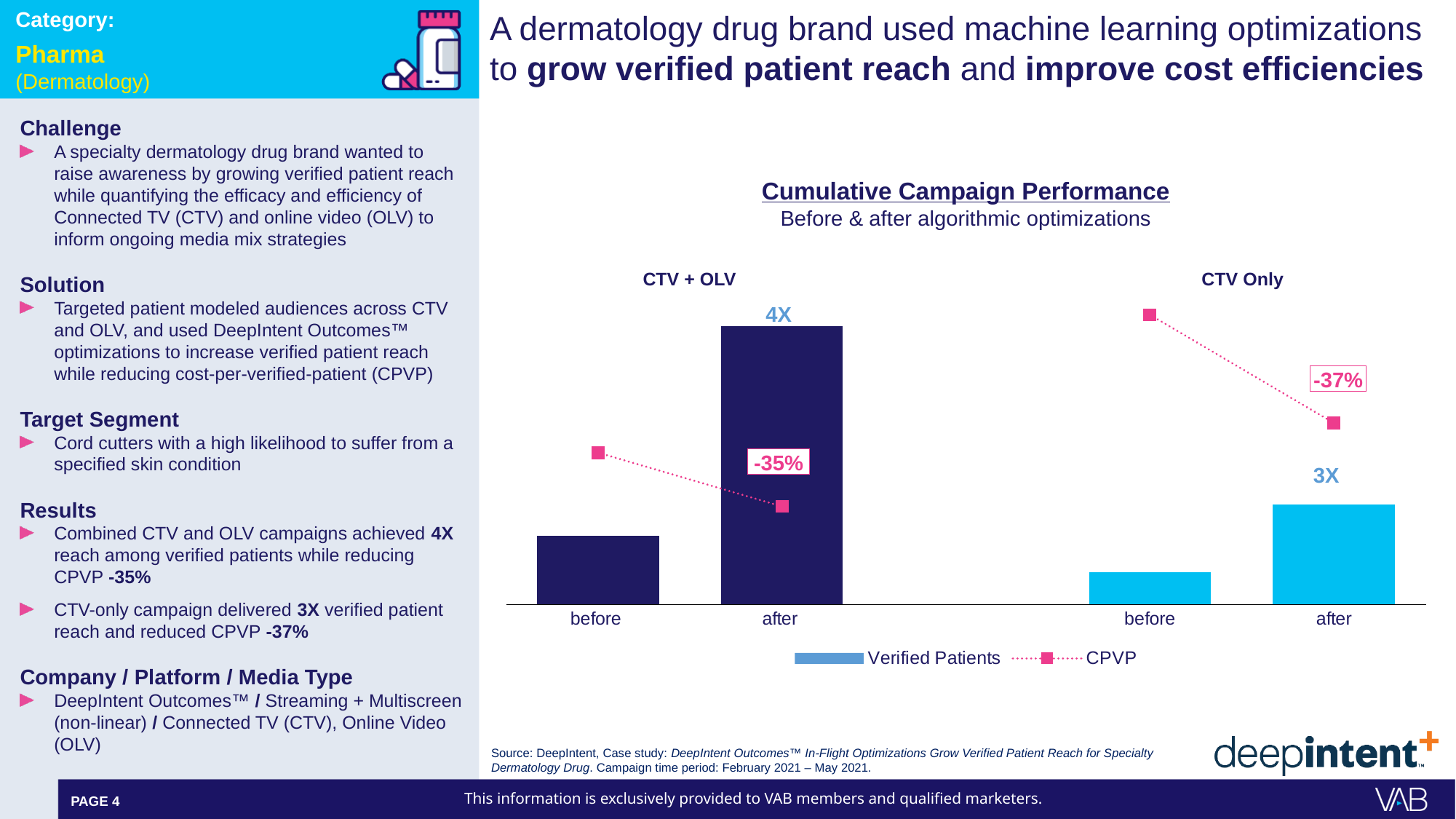
What kind of chart is used to show Verified Patients? bar chart What change in CPVP is labeled for the CTV + OLV campaign? -35% Does the CPVP line rise or fall from before to after for CTV Only? fall What is the chart's title? Cumulative Campaign Performance What is the data label on the 'after' Verified Patients bar for CTV Only? 3X How many Verified Patients bars are plotted in total? 4 Which bar is the tallest on the chart? CTV + OLV after How many series does the legend list? 2 What change in CPVP is labeled for the CTV Only campaign? -37% Which 'after' bar is taller, CTV + OLV or CTV Only? CTV + OLV What are the two series named in the legend? Verified Patients and CPVP What is the data label on the 'after' Verified Patients bar for CTV + OLV? 4X